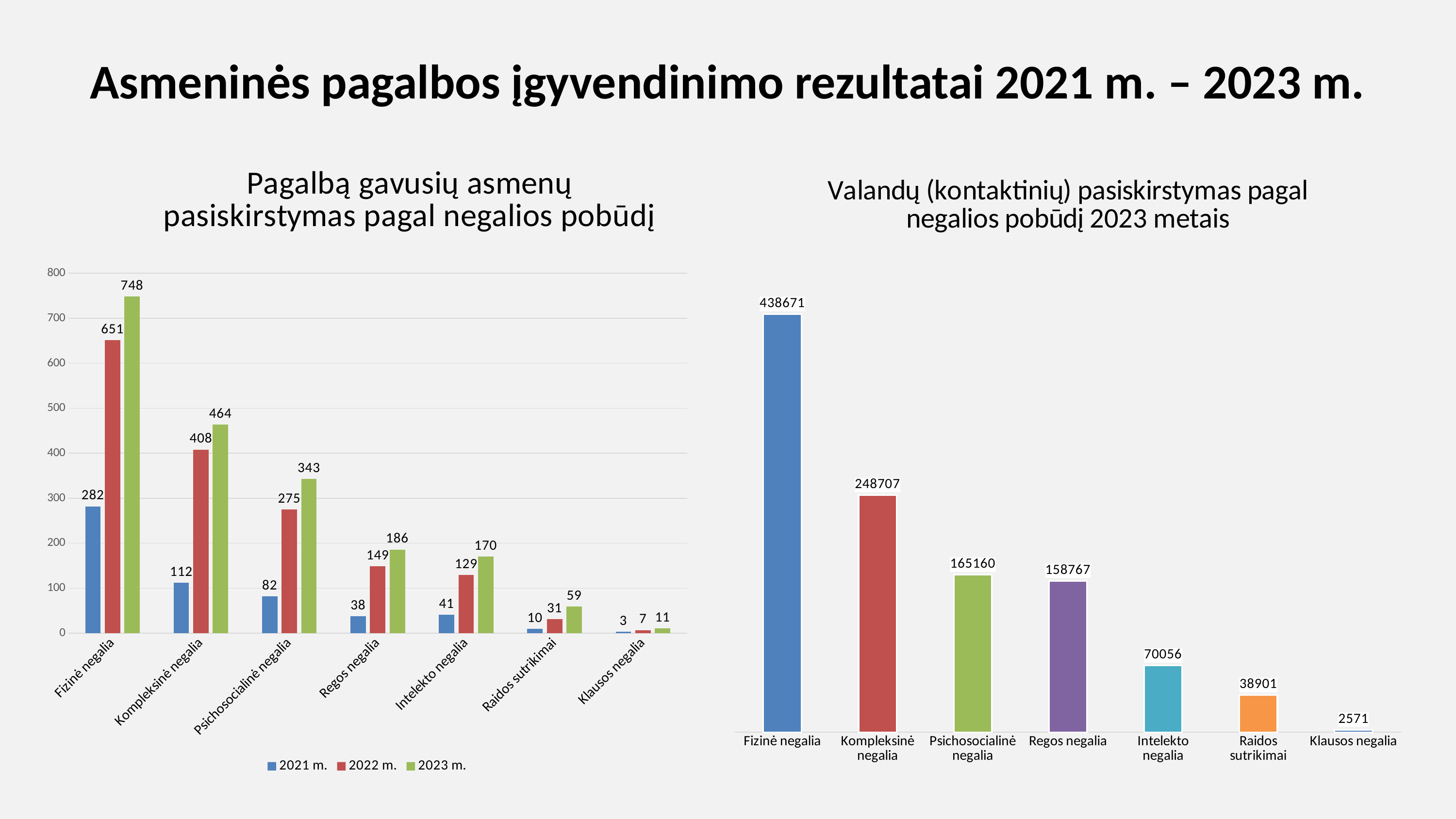
In the left chart 'Pagalbą gavusių asmenų pasiskirstymas pagal negalios pobūdį', how many series does the legend list? 3 In the left chart 'Pagalbą gavusių asmenų pasiskirstymas pagal negalios pobūdį', which category has the lowest value in 2022 m.? Klausos negalia In the right chart 'Valandų (kontaktinių) pasiskirstymas pagal negalios pobūdį 2023 metais', how many categories are shown? 7 In the left chart 'Pagalbą gavusių asmenų pasiskirstymas pagal negalios pobūdį', do the values for Regos negalia rise or fall from 2021 m. to 2023 m.? rise What kind of chart is the right chart 'Valandų (kontaktinių) pasiskirstymas pagal negalios pobūdį 2023 metais'? bar chart In the left chart 'Pagalbą gavusių asmenų pasiskirstymas pagal negalios pobūdį', what is the difference between the 2023 m. and 2022 m. values for Kompleksinė negalia? 56 In the right chart 'Valandų (kontaktinių) pasiskirstymas pagal negalios pobūdį 2023 metais', which category has the highest value? Fizinė negalia In the left chart 'Pagalbą gavusių asmenų pasiskirstymas pagal negalios pobūdį', what is the value for Psichosocialinė negalia in 2021 m.? 82 In the right chart 'Valandų (kontaktinių) pasiskirstymas pagal negalios pobūdį 2023 metais', what is the difference between Fizinė negalia and Kompleksinė negalia? 189964 In the left chart 'Pagalbą gavusių asmenų pasiskirstymas pagal negalios pobūdį', which is larger: Intelekto negalia in 2022 m. or Regos negalia in 2022 m.? Regos negalia In the left chart 'Pagalbą gavusių asmenų pasiskirstymas pagal negalios pobūdį', what is the value for Fizinė negalia in 2023 m.? 748 In the right chart 'Valandų (kontaktinių) pasiskirstymas pagal negalios pobūdį 2023 metais', what is the value for Regos negalia? 158767